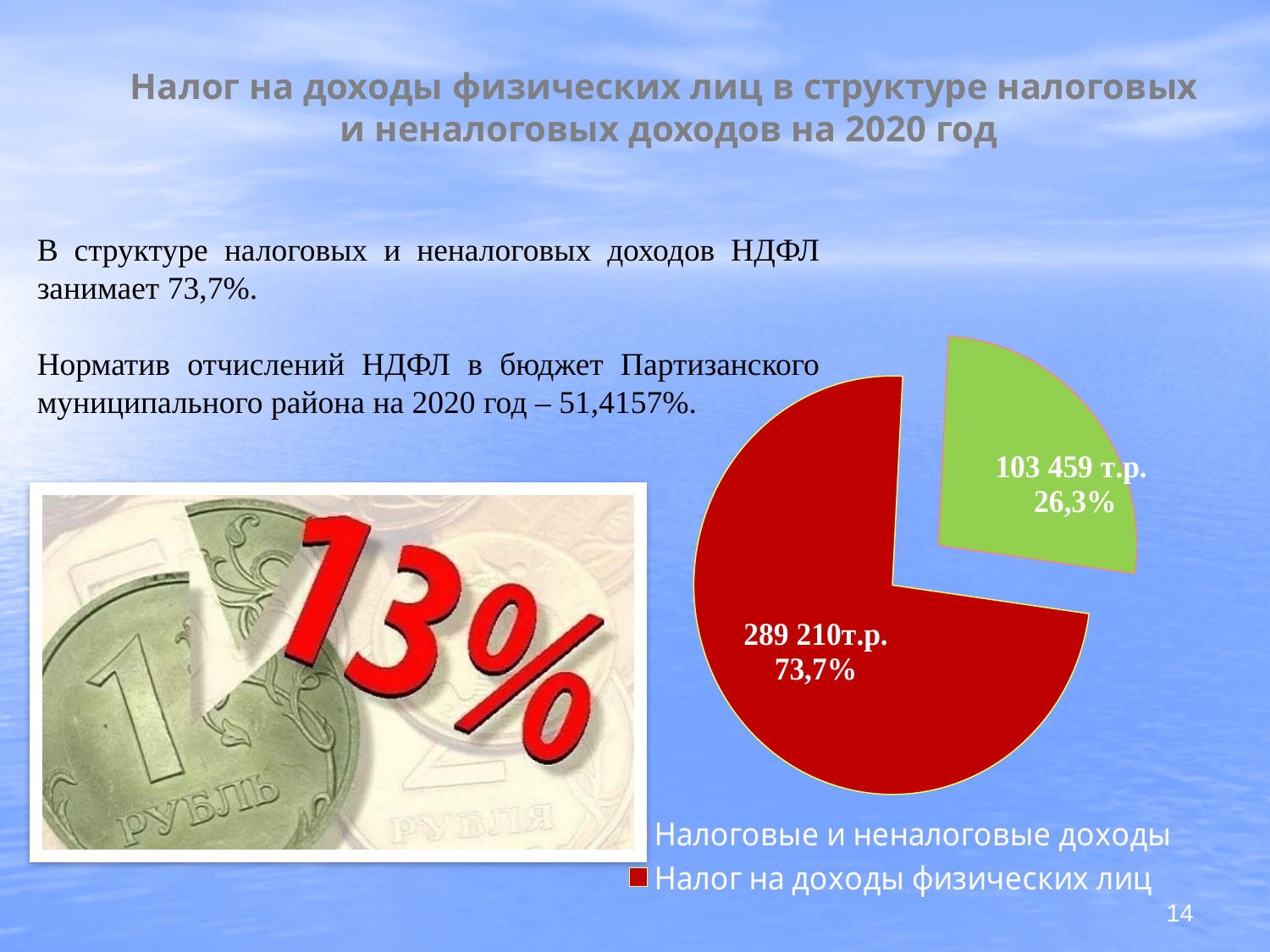
What kind of chart is shown on the slide? pie chart What is the difference between the values of the red slice (289 210) and the green slice (103 459) in the pie chart? 185 751 Which is larger: the red slice or the green slice of the pie chart? the red slice What colour is the slice labelled 'Налог на доходы физических лиц' in the pie chart? red Which slice of the pie chart is the smallest? Налоговые и неналоговые доходы What percentage is shown on the green slice of the pie chart? 26,3% What value is shown on the green slice of the pie chart? 103 459 т.р. What value is shown on the red slice of the pie chart? 289 210т.р. Which slice of the pie chart is the largest? Налог на доходы физических лиц How many entries does the legend of the pie chart list? 2 How many slices does the pie chart have? 2 What percentage is shown for the slice labelled 'Налог на доходы физических лиц'? 73,7%